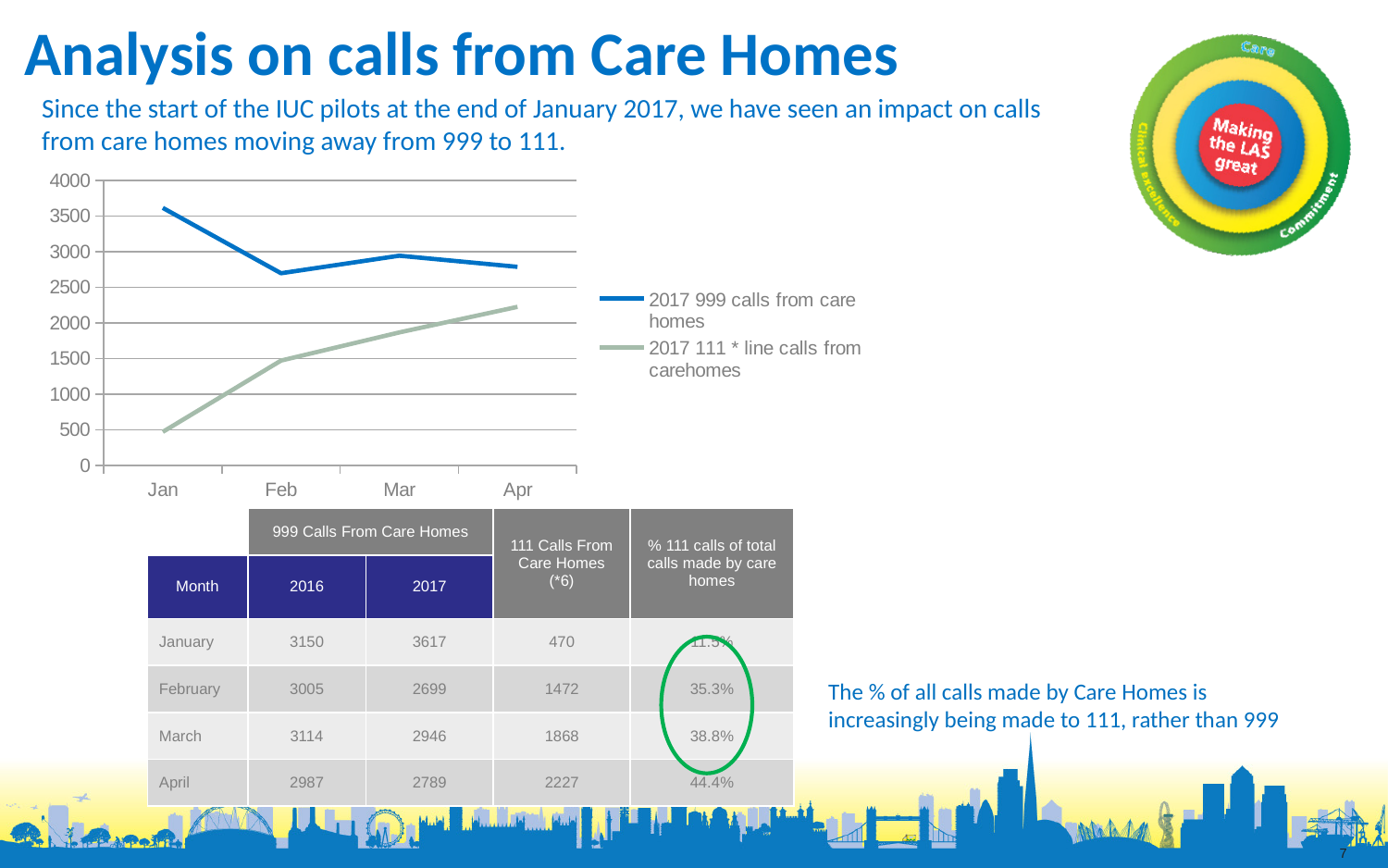
In Apr, which series is larger: 2017 999 calls from care homes or 2017 111 line calls from care homes? 2017 999 calls from care homes Which month has the lowest value for 2017 111 line calls from care homes? Jan Is the value for 2017 999 calls from care homes in Jan greater or less than 3500? greater How many months are plotted along the x axis of the chart? 4 Do the 2017 111 line calls from care homes rise or fall from Jan to Apr? rise Which month has the highest value for 2017 999 calls from care homes? Jan How many series does the chart's legend list? 2 Is the value for 2017 111 line calls from care homes in Jan greater or less than 500? less According to the table, what was the number of 111 calls from care homes in April? 2227 What colour is the line for 2017 999 calls from care homes? blue According to the table, what was the number of 2017 999 calls from care homes in January? 3617 What kind of chart is shown on the slide? line chart